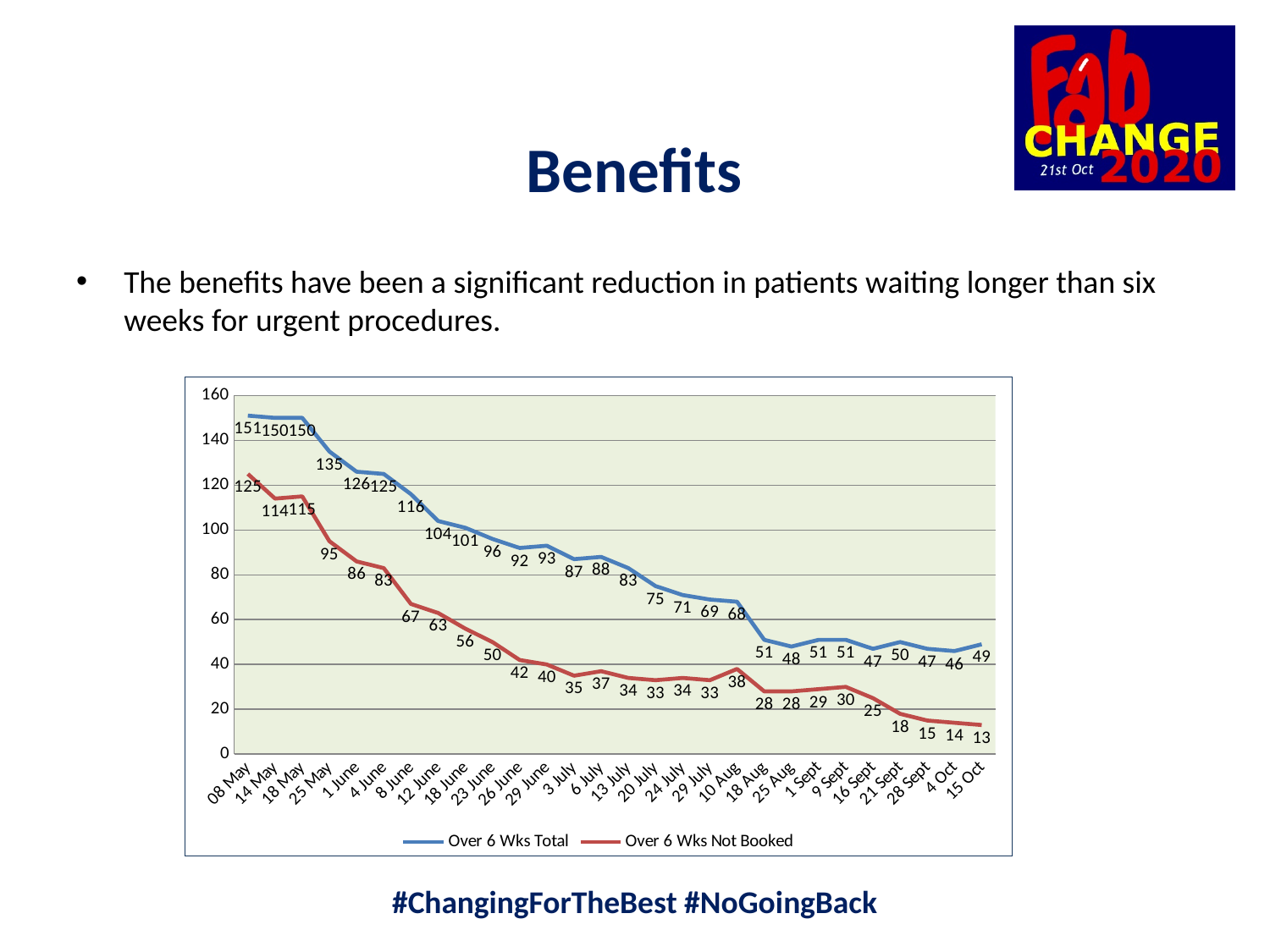
What kind of chart is shown on the slide? line chart Do the values of Over 6 Wks Total generally rise or fall from 08 May to 15 Oct? fall How many series does the legend list? 2 What are the two series named in the legend? Over 6 Wks Total and Over 6 Wks Not Booked What is the value of Over 6 Wks Not Booked on 25 May? 95 How many dates are plotted along the x axis? 28 What is the value of Over 6 Wks Not Booked on 15 Oct? 13 Which date has the larger Over 6 Wks Total value, 10 Aug or 18 Aug? 10 Aug What is the value of Over 6 Wks Total on 08 May? 151 What is the difference between Over 6 Wks Total and Over 6 Wks Not Booked on 08 May? 26 On which date is Over 6 Wks Total at its highest? 08 May On which date is Over 6 Wks Not Booked at its lowest? 15 Oct